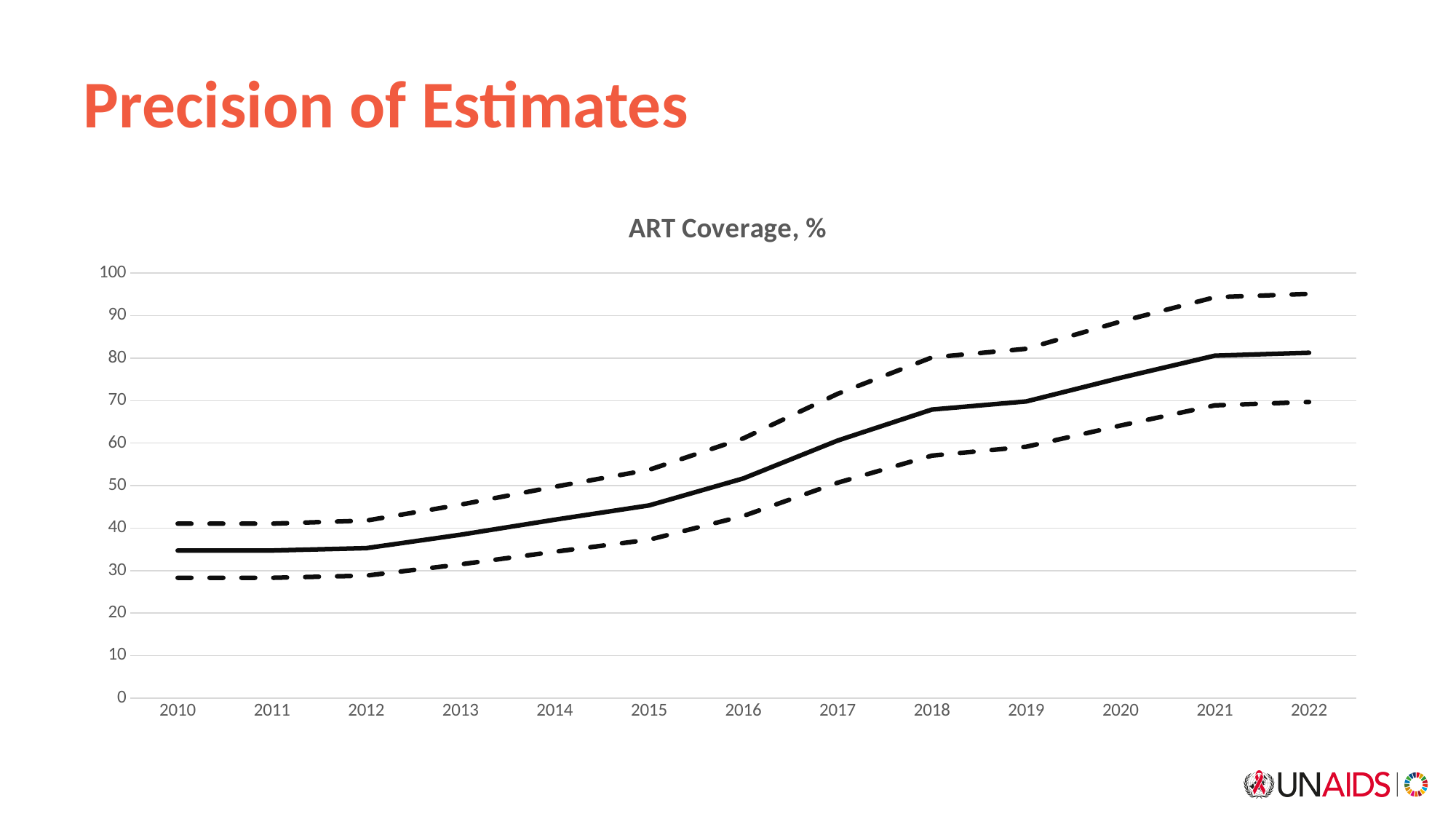
Is the value of the upper dashed line in 2022 greater or less than 90? greater How many years are shown on the x axis of the chart? 13 How are the upper and lower lines on the chart drawn, compared with the middle line? dashed Is the value of the solid line in 2022 greater or less than 70? greater Is the value of the solid line in 2010 greater or less than 40? less What is the title of the chart? ART Coverage, % Is the value of the solid line in 2022 larger than its value in 2010? yes How many lines are plotted on the chart? 3 What kind of chart is shown on the slide? line chart Do the values of the solid line rise or fall from 2010 to 2022? rise